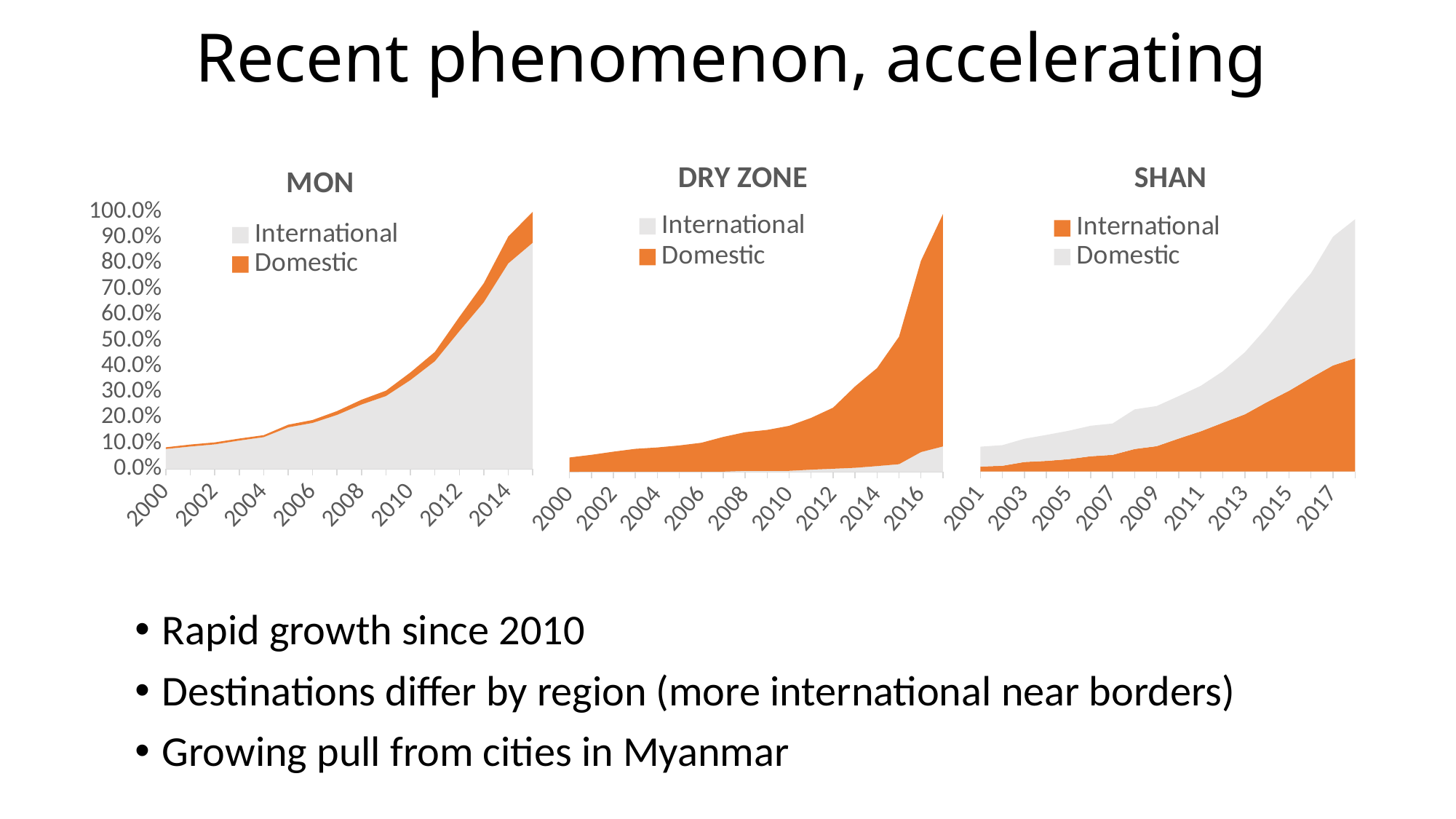
In the DRY ZONE chart, does the total rise or fall over the years shown? Rise In the MON chart, do the stacked values rise or fall from 2000 to 2015? Rise In the MON chart, is the total value for 2000 greater or less than 10.0%? less In the SHAN chart, which series is larger in the final year shown, International or Domestic? Domestic What are the titles of the three charts on the slide, from left to right? MON, DRY ZONE, SHAN Which colour represents Domestic in the SHAN chart? Grey In the MON chart, which series is larger in 2015, International or Domestic? International In the DRY ZONE chart, which series is larger in 2017, International or Domestic? Domestic In the MON chart, is the total value for 2012 greater or less than 40.0%? greater In the MON chart, is the total value for 2014 greater or less than 80.0%? greater How many series does the legend of the DRY ZONE chart list? 2 What kind of chart is the MON chart? Stacked area chart